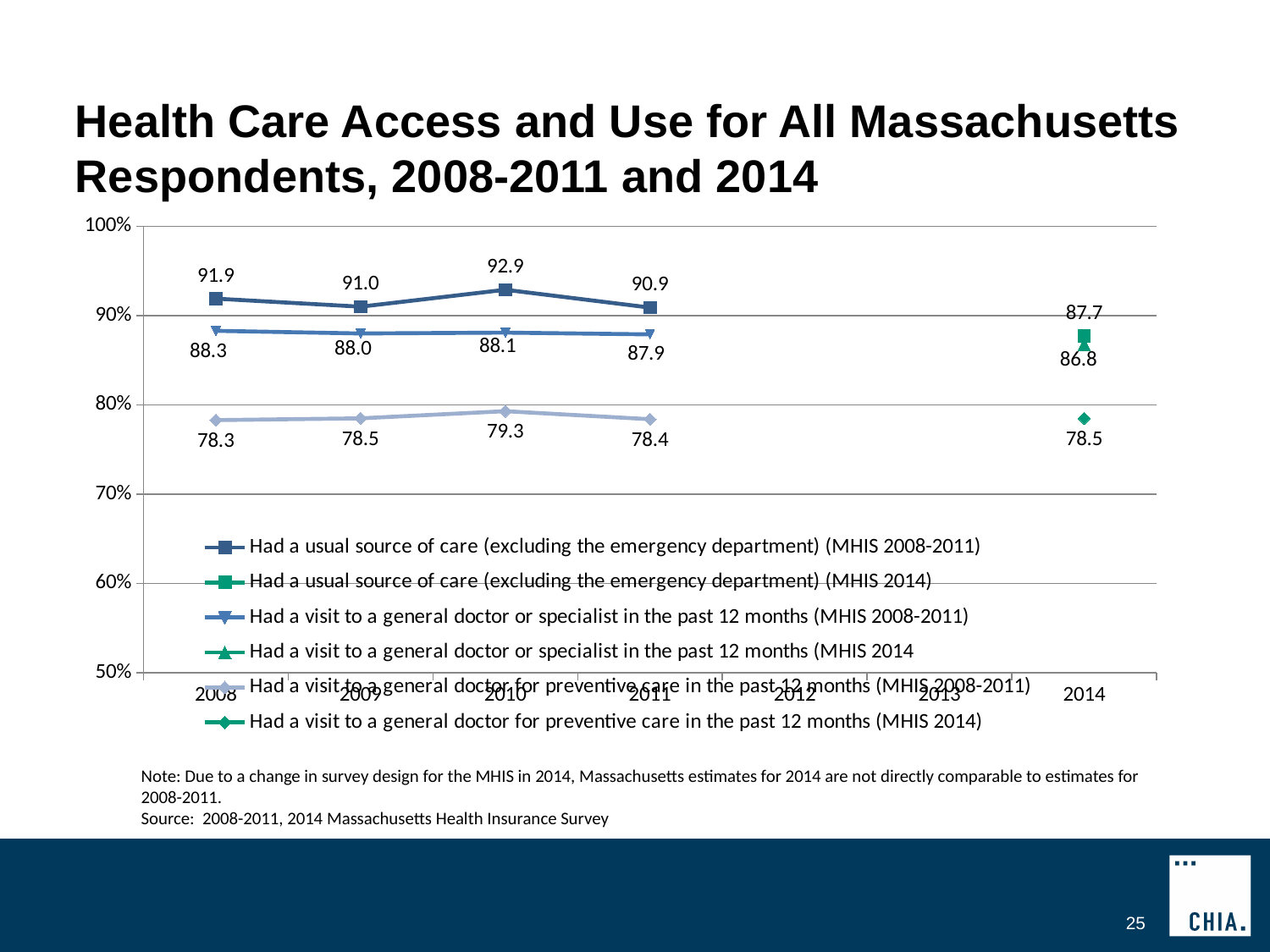
In which year is the value for 'Had a visit to a general doctor for preventive care in the past 12 months (MHIS 2008-2011)' lowest? 2008 Is the 2014 value for 'Had a visit to a general doctor or specialist in the past 12 months (MHIS 2014)' greater or less than 90%? less What kind of chart is shown on the slide? Line chart What is the value for 'Had a usual source of care (excluding the emergency department) (MHIS 2008-2011)' in 2010? 92.9 How many years are labelled on the x axis? 7 Does the value for 'Had a usual source of care (excluding the emergency department) (MHIS 2008-2011)' rise or fall from 2010 to 2011? Fall What is the difference between the 2010 and 2011 values for 'Had a usual source of care (excluding the emergency department) (MHIS 2008-2011)'? 2.0 What is the value for 'Had a visit to a general doctor for preventive care in the past 12 months (MHIS 2014)'? 78.5 For 2014, which is larger: the value for 'Had a usual source of care (excluding the emergency department)' or the value for 'Had a visit to a general doctor or specialist in the past 12 months'? Had a usual source of care (excluding the emergency department) What is the value for 'Had a visit to a general doctor or specialist in the past 12 months (MHIS 2008-2011)' in 2011? 87.9 In which year is the value for 'Had a usual source of care (excluding the emergency department) (MHIS 2008-2011)' highest? 2010 How many series does the legend list? 6